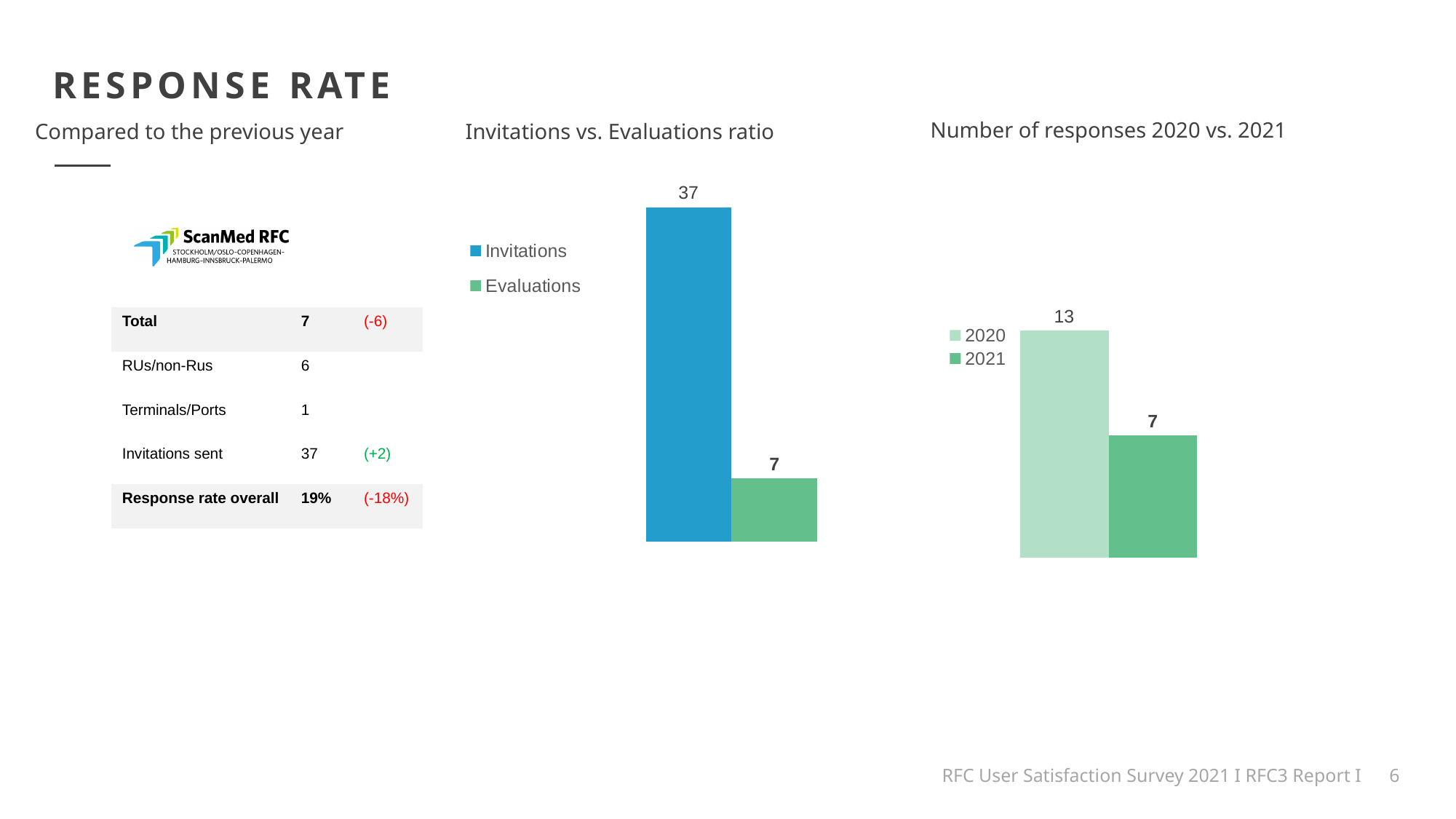
What kind of chart is the 'Invitations vs. Evaluations ratio' chart? Bar chart In the 'Invitations vs. Evaluations ratio' chart, what colour is the Invitations bar? Blue In the 'Invitations vs. Evaluations ratio' chart, which series has the higher value? Invitations In the 'Invitations vs. Evaluations ratio' chart, how many series does the legend list? 2 In the 'Number of responses 2020 vs. 2021' chart, do the values rise or fall from 2020 to 2021? Fall In the 'Number of responses 2020 vs. 2021' chart, what is the value for 2021? 7 In the 'Invitations vs. Evaluations ratio' chart, what is the value for Invitations? 37 In the 'Number of responses 2020 vs. 2021' chart, what is the value for 2020? 13 In the 'Number of responses 2020 vs. 2021' chart, by how much did the number of responses fall from 2020 to 2021? 6 In the 'Invitations vs. Evaluations ratio' chart, what is the difference between Invitations and Evaluations? 30 In the 'Number of responses 2020 vs. 2021' chart, which year has the lower number of responses? 2021 In the 'Invitations vs. Evaluations ratio' chart, what is the value for Evaluations? 7